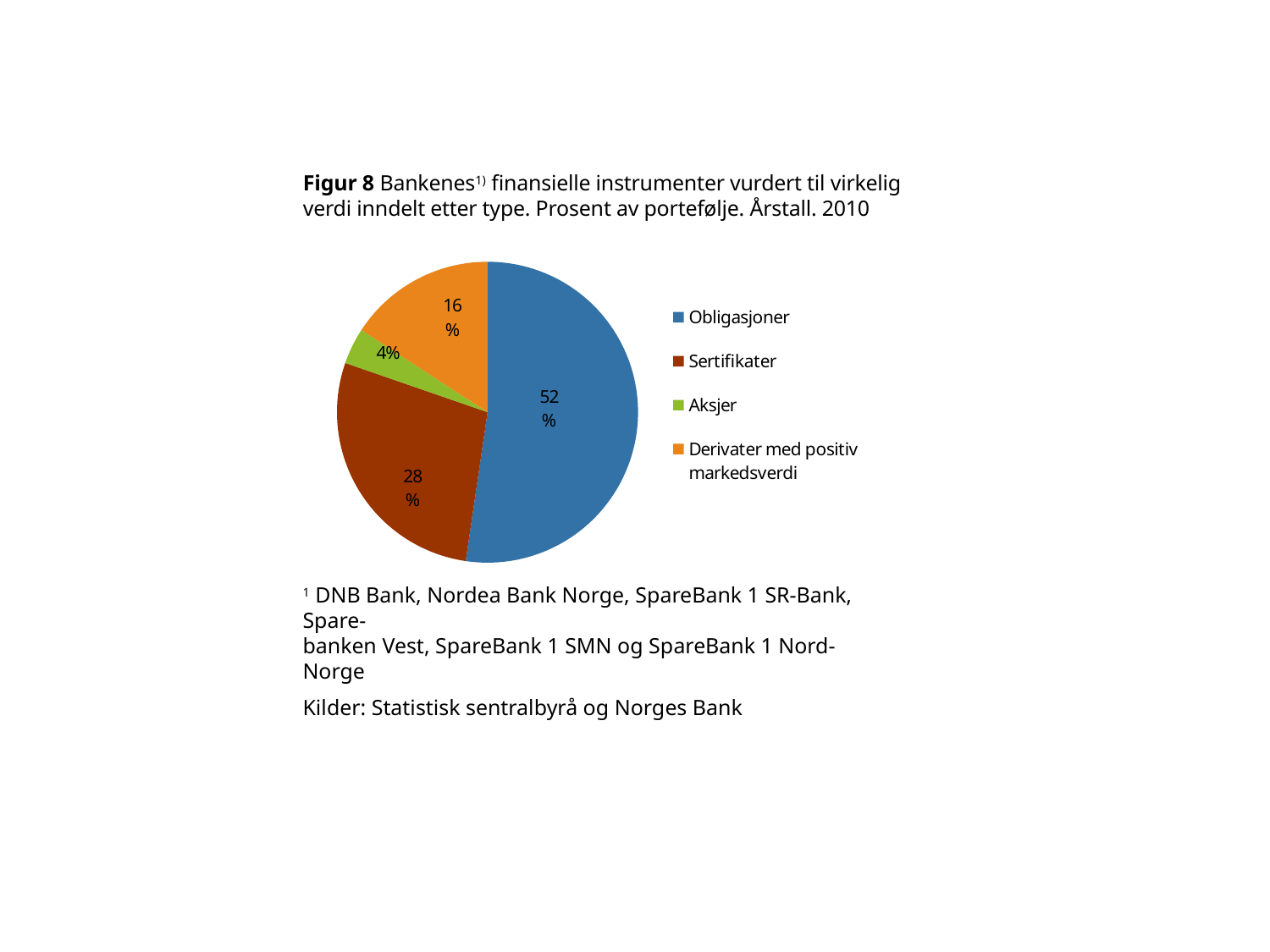
Which category has the smallest slice of the pie? Aksjer What year does the chart title refer to? 2010 What share of the portfolio is Aksjer? 4% What share of the portfolio is Derivater med positiv markedsverdi? 16% What is the difference in percentage points between Obligasjoner and Sertifikater? 24 How many categories does the pie chart show? 4 Which is larger, Sertifikater or Derivater med positiv markedsverdi? Sertifikater Which category has the largest slice of the pie? Obligasjoner What share of the portfolio is Obligasjoner? 52% What colour is the Aksjer slice? green What share of the portfolio is Sertifikater? 28% What kind of chart is shown on the slide? pie chart